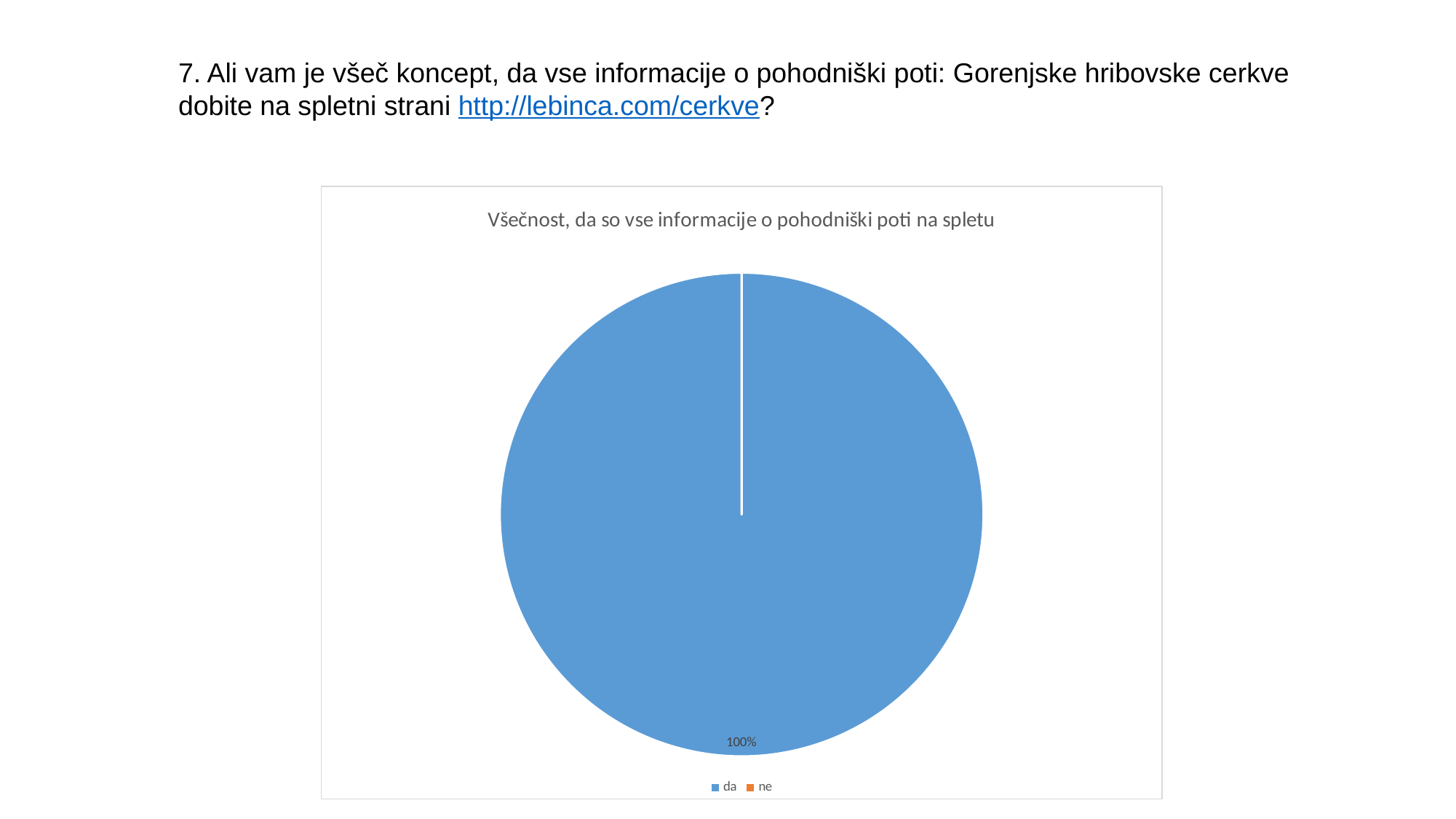
Which is larger, the slice for "da" or the slice for "ne"? da What share of the pie does the "da" slice take? 100% What are the two categories listed in the legend? da, ne What colour is the "da" slice in the legend? blue Which category has the smallest slice of the pie? ne Which category has the largest slice of the pie? da What is the title of the chart? Všečnost, da so vse informacije o pohodniški poti na spletu What kind of chart is shown on the slide? pie chart How many entries does the chart legend list? 2